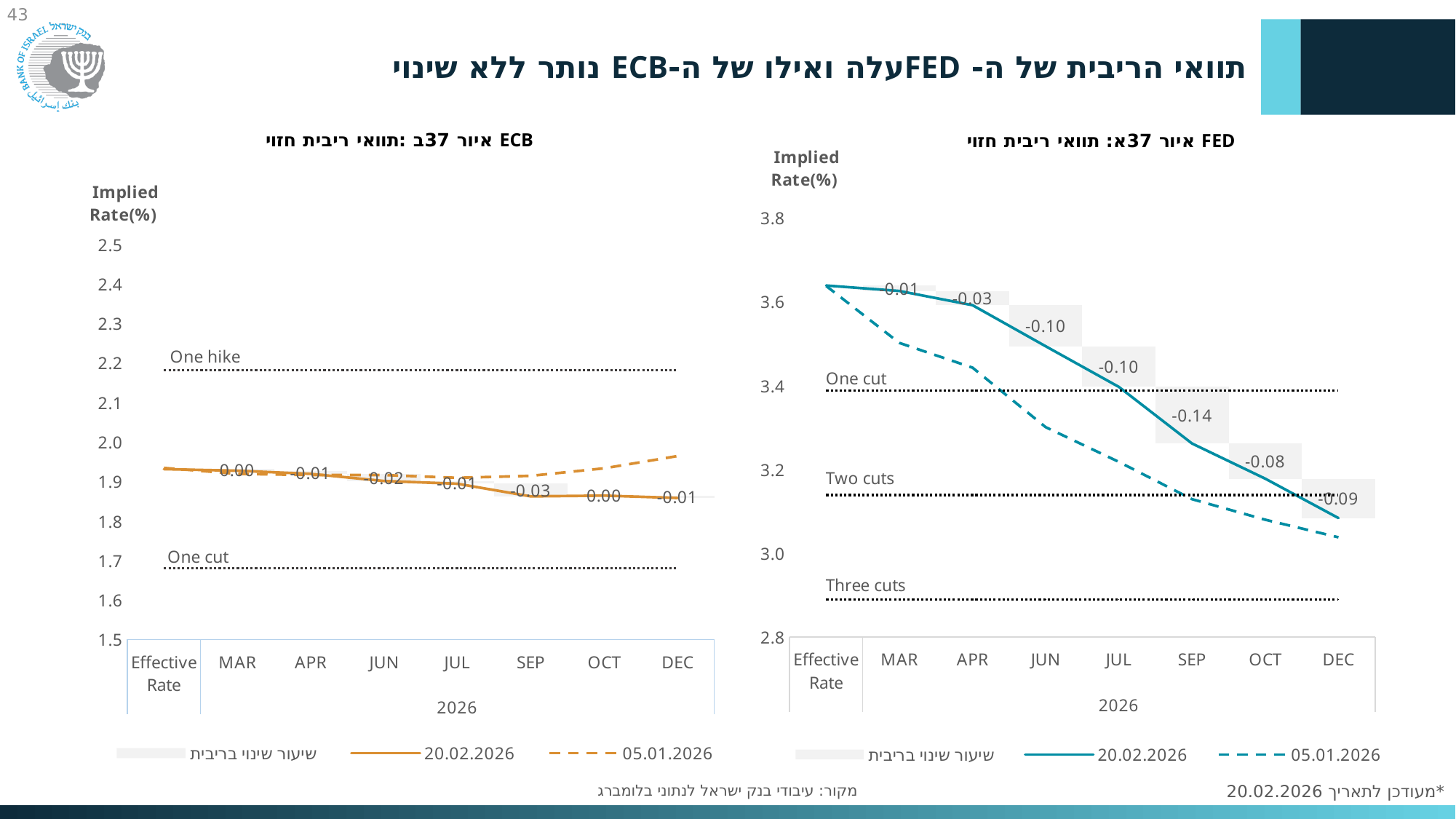
In the FED chart (right), is the 20.02.2026 implied rate for DEC greater or less than 3.2? less In the FED chart (right), does the 20.02.2026 line rise or fall from Effective Rate to DEC? fall How many entries does the legend of the FED chart (right) list? 3 In the FED chart (right), what is the rate change label shown for SEP? -0.14 In the FED chart (right), which month has the largest negative rate change label? SEP In the FED chart (right), is the Effective Rate value greater or less than 3.6? greater In the FED chart (right), what is the difference between the rate change labels for SEP and OCT? 0.06 In the FED chart (right), what is the rate change label shown for JUN? -0.10 In the FED chart (right), is the rate change label for APR or for JUN larger in magnitude? JUN In the ECB chart (left), what is the rate change label shown for OCT? 0.00 How many x-axis categories does the ECB chart (left) show? 8 In the ECB chart (left), what is the rate change label shown for SEP? -0.03